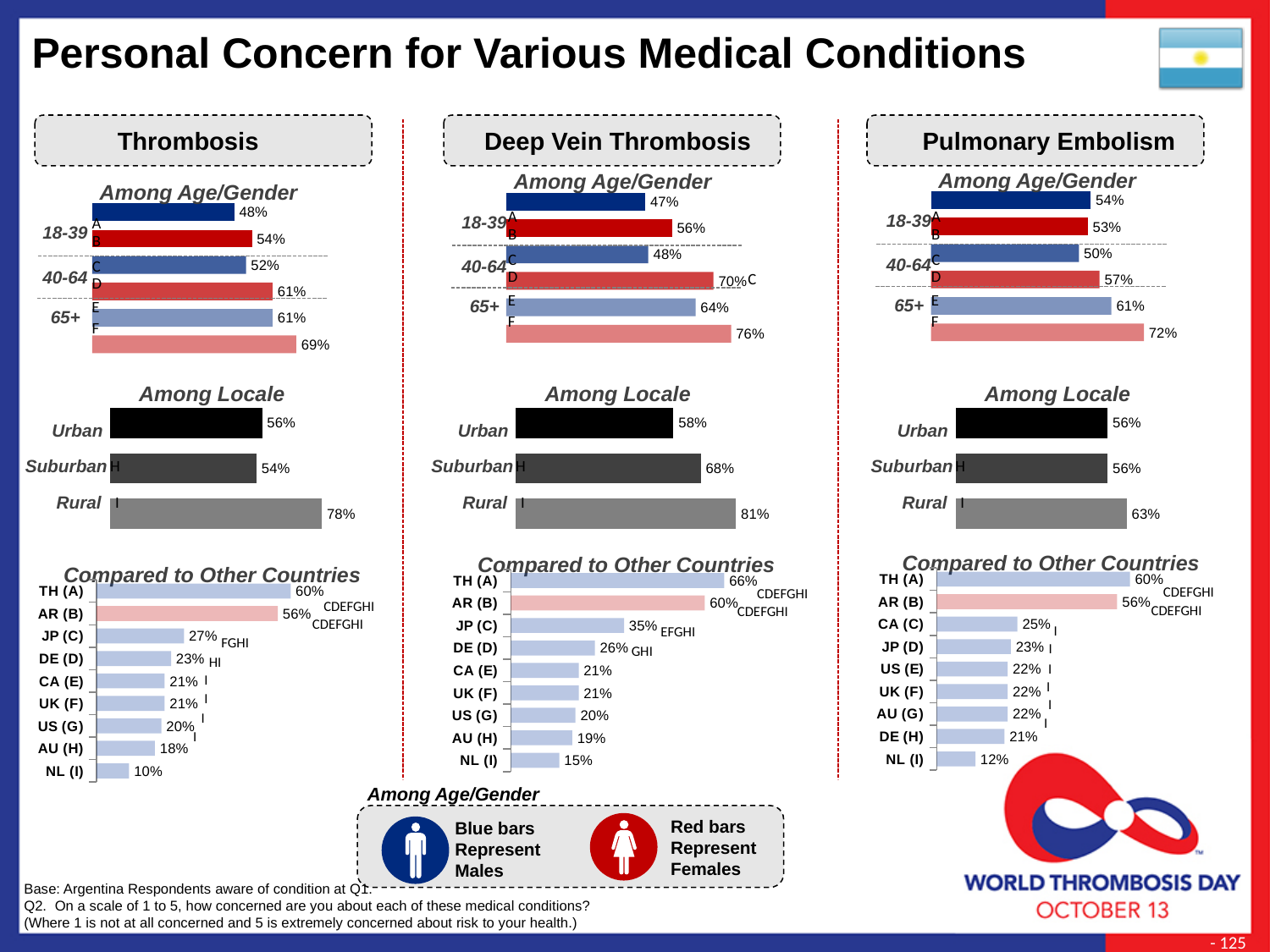
In the Thrombosis 'Compared to Other Countries' chart, which country has the lowest value? NL (I) In the Deep Vein Thrombosis 'Compared to Other Countries' chart, which country has the highest value? TH (A) In the Pulmonary Embolism 'Compared to Other Countries' chart, what is the value for NL (I)? 12% In the Pulmonary Embolism 'Among Locale' chart, what is the difference between Rural and Urban? 7% According to the legend at the bottom of the slide, what do the red bars in the 'Among Age/Gender' charts represent? Females In the Thrombosis 'Among Age/Gender' chart, what is the difference between bar F (65+ females) and bar A (18-39 males)? 21% In the Deep Vein Thrombosis 'Among Locale' chart, which is larger, Suburban or Urban? Suburban How many countries are listed in the Pulmonary Embolism 'Compared to Other Countries' chart? 9 In the Deep Vein Thrombosis 'Among Age/Gender' chart, what is the value for bar D (40-64 females)? 70% What type of chart is the Thrombosis 'Among Locale' chart? Bar chart In the Thrombosis 'Among Locale' chart, what is the value for Rural? 78% In the Pulmonary Embolism 'Among Age/Gender' chart, which bar has the highest value? F (65+ females)